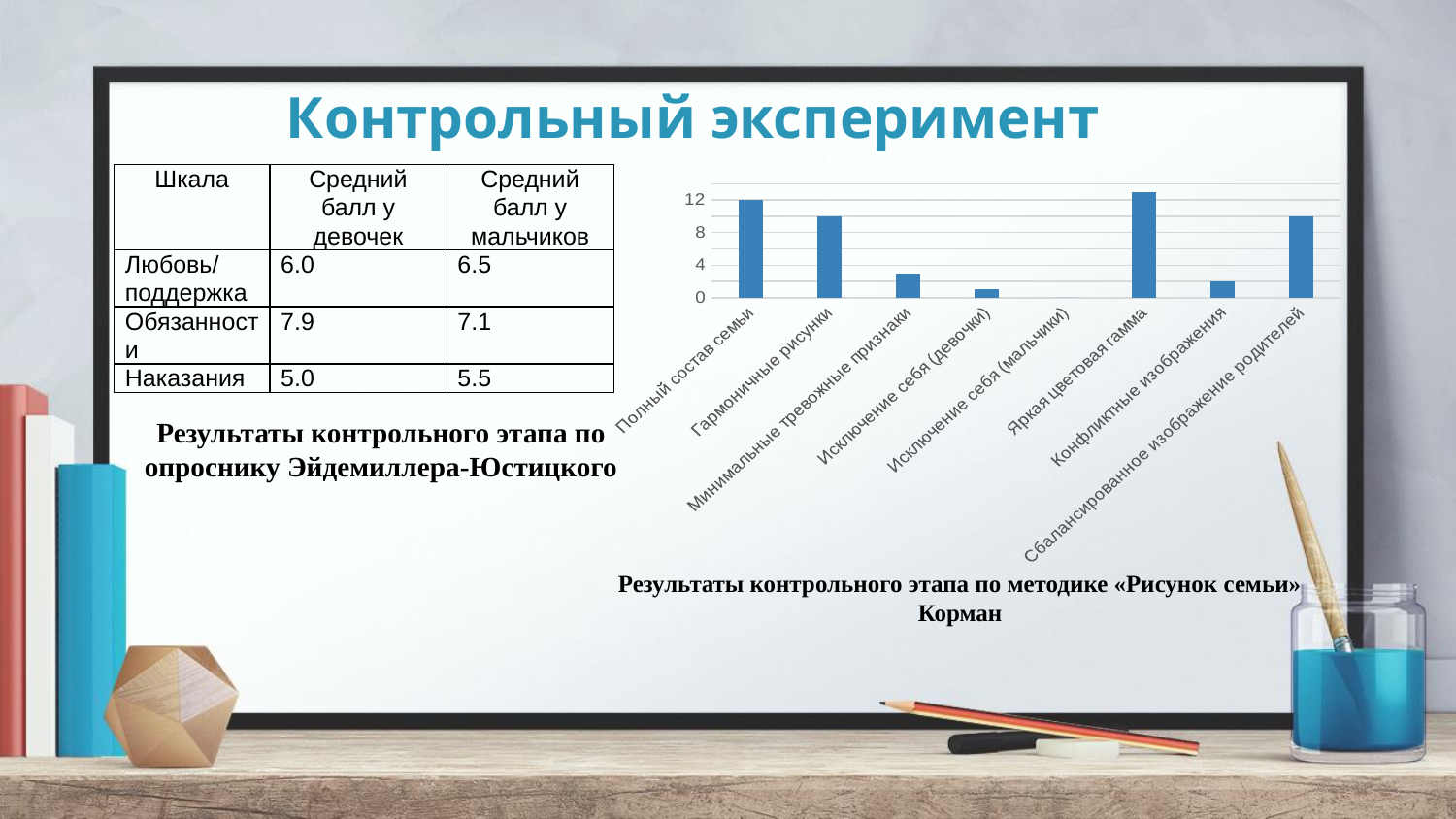
What is the highest tick value shown on the vertical axis of the chart? 12 Is the value for Яркая цветовая гамма greater or less than 12? greater Is the value for Минимальные тревожные признаки greater or less than 4? less Which is larger: the value for Полный состав семьи or the value for Конфликтные изображения? Полный состав семьи Which category has the lowest value in the chart? Исключение себя (мальчики) How many categories are shown on the x axis of the bar chart? 8 What caption is written below the bar chart? Результаты контрольного этапа по методике «Рисунок семьи» Корман Is the value for Гармоничные рисунки greater or less than 8? greater Which is larger: the value for Сбалансированное изображение родителей or the value for Минимальные тревожные признаки? Сбалансированное изображение родителей What kind of chart is shown on the slide? Bar chart Which category has the tallest bar in the chart? Яркая цветовая гамма